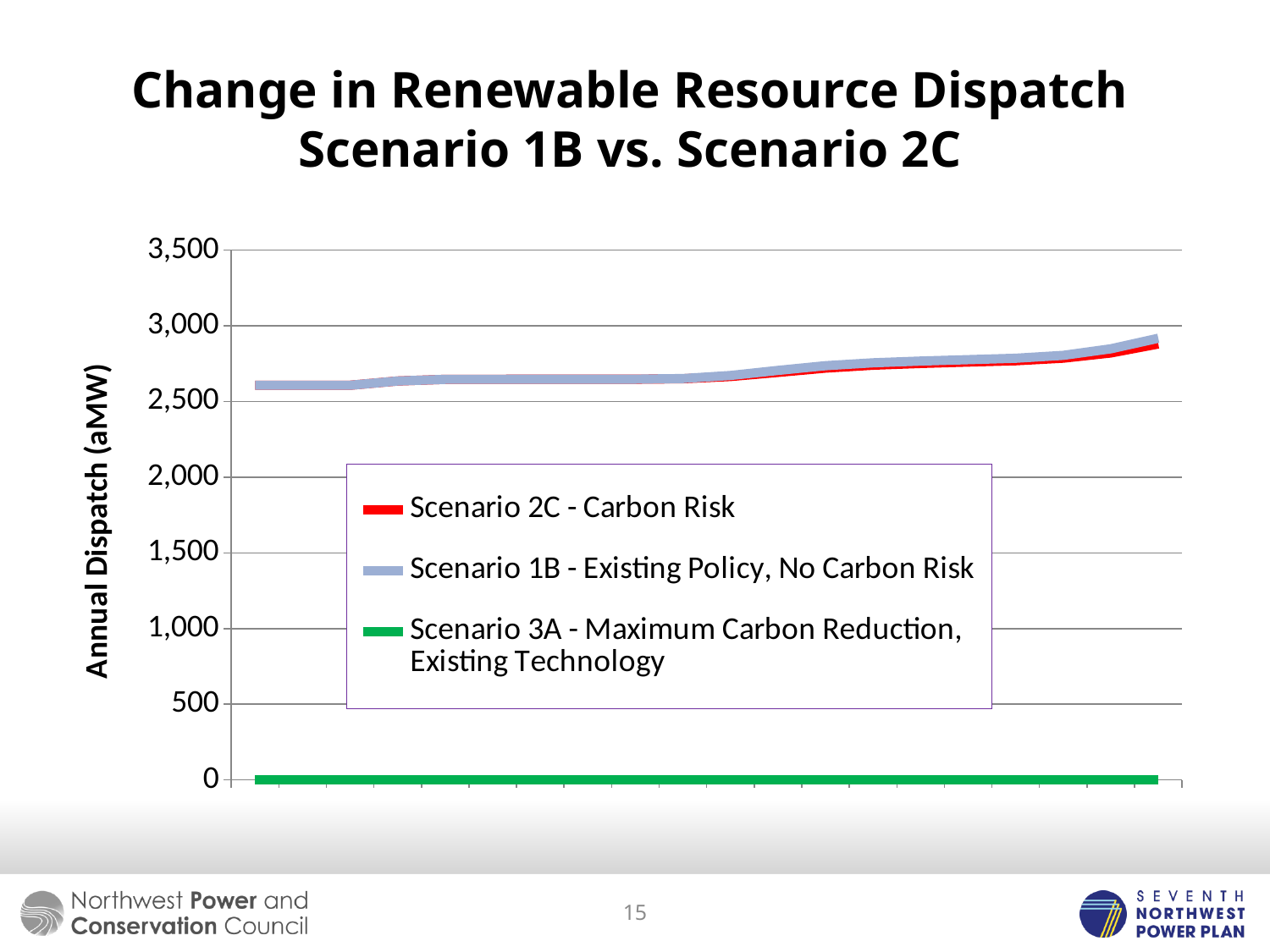
Do the values for Scenario 3A - Maximum Carbon Reduction, Existing Technology rise, fall, or stay flat along the x axis? stay flat What is the label of the vertical axis? Annual Dispatch (aMW) Do the values for Scenario 1B - Existing Policy, No Carbon Risk rise or fall along the x axis? rise What kind of chart is shown on the slide? line chart Which series has larger values, Scenario 1B - Existing Policy, No Carbon Risk or Scenario 3A - Maximum Carbon Reduction, Existing Technology? Scenario 1B - Existing Policy, No Carbon Risk Are the values for Scenario 3A - Maximum Carbon Reduction, Existing Technology greater or less than 500? less Are the values for Scenario 1B - Existing Policy, No Carbon Risk greater or less than 3,000? less What is the title of the chart on the slide? Change in Renewable Resource Dispatch Scenario 1B vs. Scenario 2C How many series does the legend list? 3 Which series has the lowest values throughout the chart? Scenario 3A - Maximum Carbon Reduction, Existing Technology Are the values for Scenario 2C - Carbon Risk greater or less than 2,500? greater